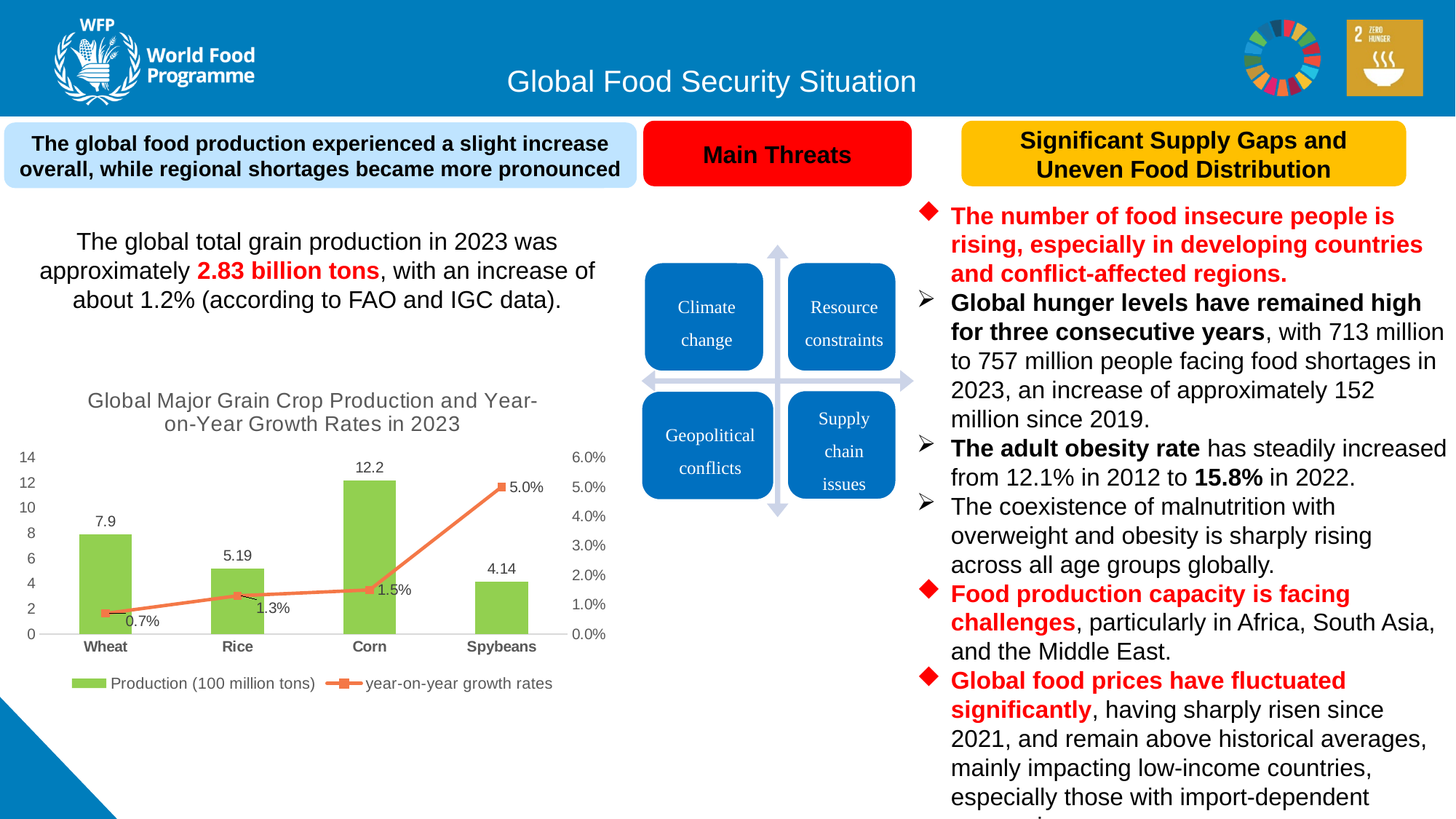
What is the production value for Rice? 5.19 What is the year-on-year growth rate for Spybeans? 5.0% How many crop categories are shown on the x axis? 4 What is the year-on-year growth rate for Wheat? 0.7% Do the year-on-year growth rates rise or fall from Wheat to Spybeans along the x axis? rise Which crop has the lowest year-on-year growth rate? Wheat What kind of chart is used to show the Production series? bar chart What is the production value for Corn? 12.2 How many series does the legend list? 2 What is the difference in production between Corn and Wheat? 4.3 Which crop has the highest production? Corn Which has a higher production value, Wheat or Spybeans? Wheat